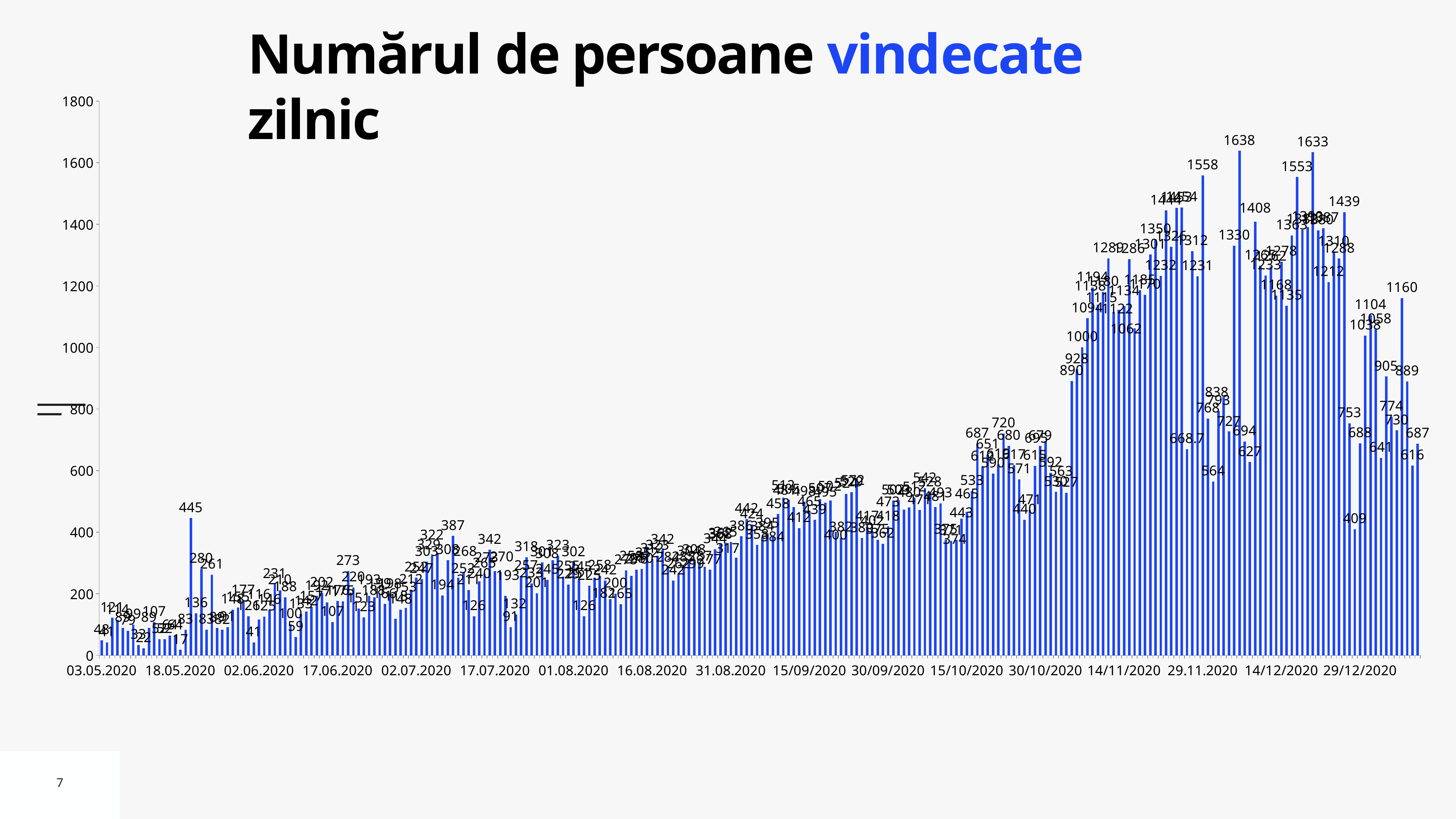
What is the difference between the two tallest bars, labeled 1638 and 1633? 5 What is the title of the chart? Numărul de persoane vindecate zilnic What is the value of the last (rightmost) bar on the chart? 687 What is the highest tick value shown on the vertical axis? 1800 What is the highest value labeled on the chart? 1638 What is the difference between the overall peak of 1638 and the May peak of 445? 1193 What is the second highest value labeled on the chart, shown shortly after 14/12/2020? 1633 Overall, do the daily values rise or fall from May 2020 to December 2020? rise Which is larger, the peak labeled 1638 or the peak labeled 1633? 1638 Is the value of the first bar at 03.05.2020 greater or less than 200? less What kind of chart is shown on the slide? bar chart What is the highest value labeled in May 2020 (before 02.06.2020)? 445